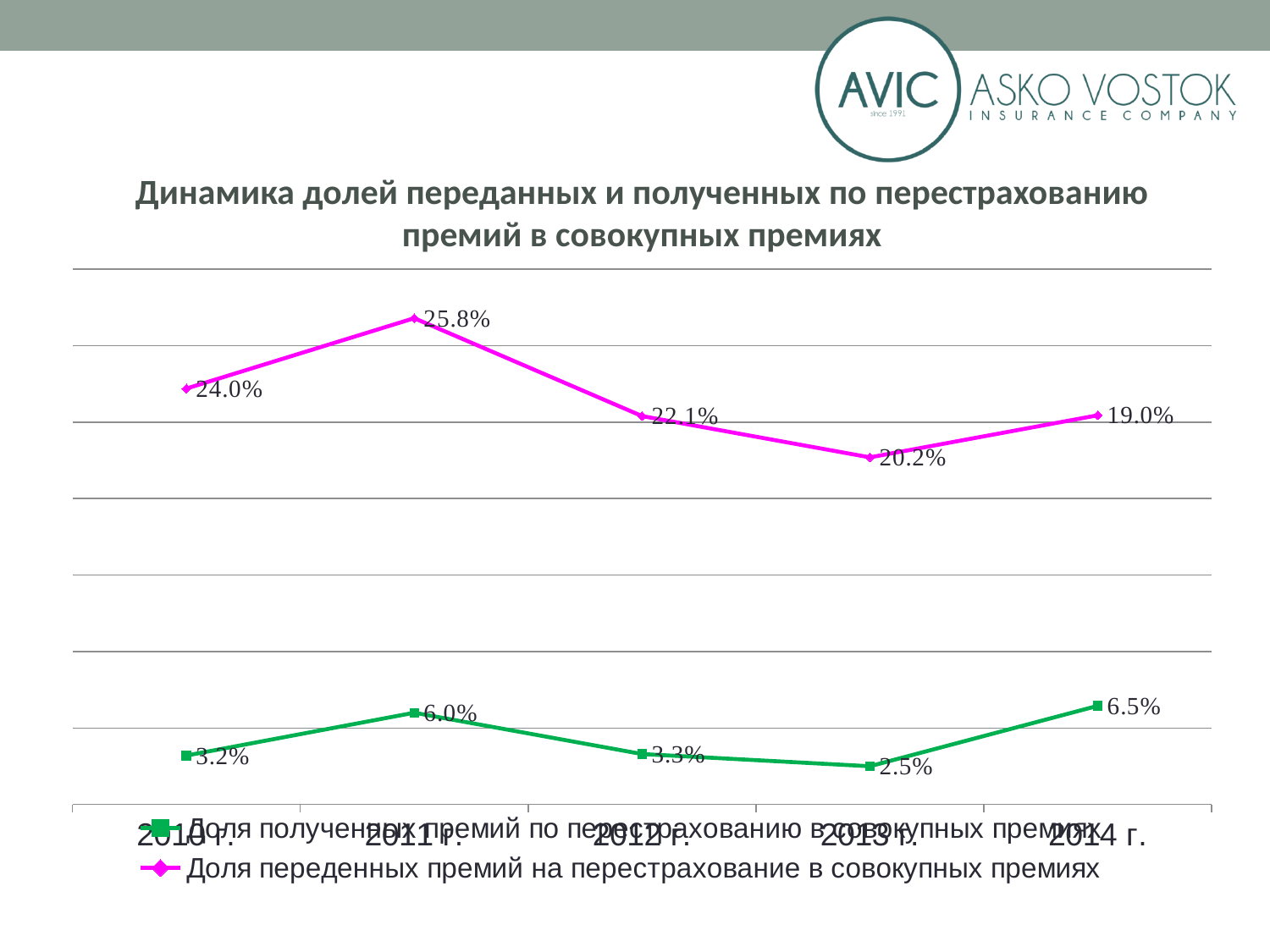
How many years are plotted along the x axis? 5 How many series does the legend list? 2 In which year is the share of premiums ceded to reinsurance the highest? 2011 г. What type of chart is shown on the slide? Line chart What is the value of the share of premiums ceded to reinsurance in 2012? 22.1% What is the difference between the share of ceded premiums in 2010 and in 2014? 5.0% Does the share of premiums ceded to reinsurance rise or fall from 2011 to 2013? Fall In which year is the share of premiums received from reinsurance the lowest? 2013 г. What is the value of the share of premiums received from reinsurance (Доля полученных премий по перестрахованию) in 2013? 2.5% Which is larger: the share of received premiums in 2011 or in 2014? 2014 (6.5%) What is the value of the share of premiums ceded to reinsurance (Доля переденных премий на перестрахование) in 2011? 25.8% What colour is the line for the share of premiums received from reinsurance? Green